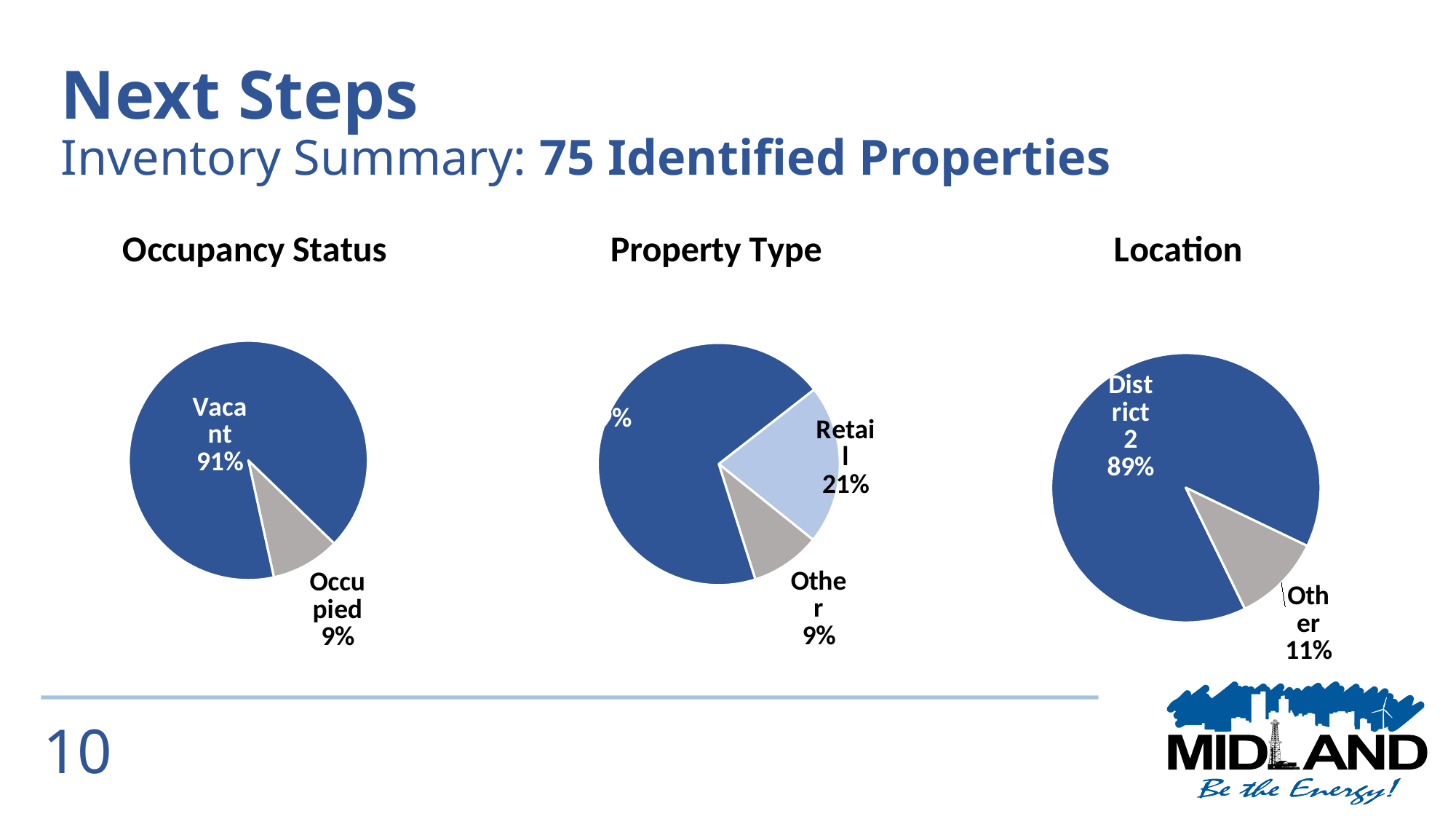
In the Property Type pie chart, what share is Retail? 21% In the Occupancy Status pie chart, what share of properties is Vacant? 91% In the Occupancy Status pie chart, which category has the largest share? Vacant How many slices does the Property Type pie chart have? 3 What type of chart is used for Occupancy Status, Property Type and Location? Pie chart In the Occupancy Status pie chart, what share of properties is Occupied? 9% In the Occupancy Status pie chart, what is the difference between the Vacant and Occupied shares? 82% In the Location pie chart, what share of properties is in District 2? 89% In the Property Type pie chart, what share is Other? 9% In the Location pie chart, which category has the smallest share? Other In the Property Type pie chart, which is larger, Retail or Other? Retail In the Location pie chart, what share of properties is Other? 11%